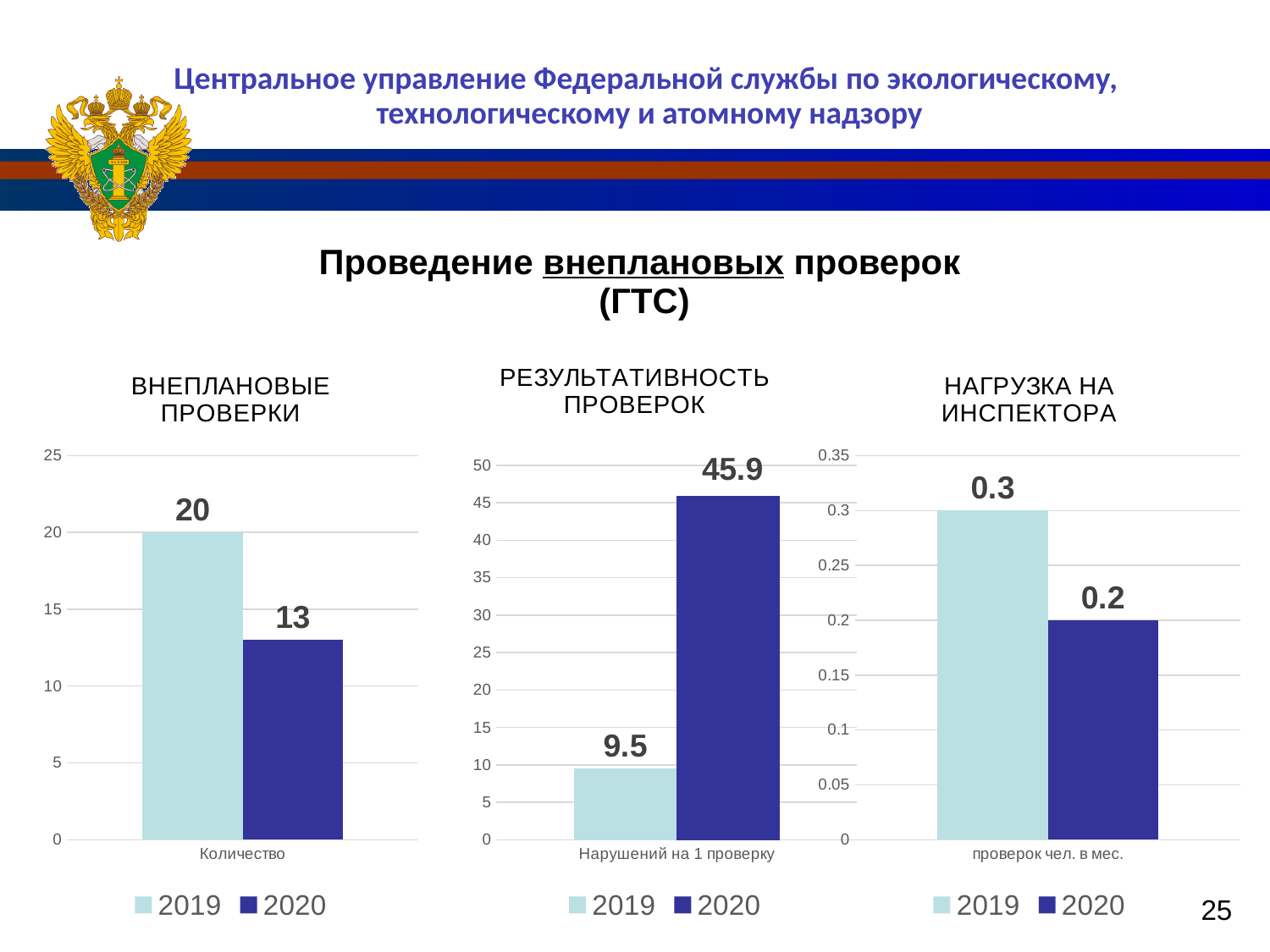
What kind of chart is the 'РЕЗУЛЬТАТИВНОСТЬ ПРОВЕРОК' chart? Bar chart In the 'РЕЗУЛЬТАТИВНОСТЬ ПРОВЕРОК' chart, which year has the higher value? 2020 In the 'РЕЗУЛЬТАТИВНОСТЬ ПРОВЕРОК' chart, what is the value for 2019? 9.5 In the 'РЕЗУЛЬТАТИВНОСТЬ ПРОВЕРОК' chart, what is the value for 2020? 45.9 In the 'НАГРУЗКА НА ИНСПЕКТОРА' chart, what is the value for 2020? 0.2 In the 'НАГРУЗКА НА ИНСПЕКТОРА' chart, what is the value for 2019? 0.3 In the 'НАГРУЗКА НА ИНСПЕКТОРА' chart, which year has the lower value? 2020 How many series does the legend of the 'ВНЕПЛАНОВЫЕ ПРОВЕРКИ' chart list? 2 In the 'РЕЗУЛЬТАТИВНОСТЬ ПРОВЕРОК' chart, what is the difference between the 2020 and 2019 values? 36.4 In the 'ВНЕПЛАНОВЫЕ ПРОВЕРКИ' chart, what is the value for 2020? 13 In the 'ВНЕПЛАНОВЫЕ ПРОВЕРКИ' chart, what is the difference between the 2019 and 2020 values? 7 In the 'ВНЕПЛАНОВЫЕ ПРОВЕРКИ' chart, what is the value for 2019? 20